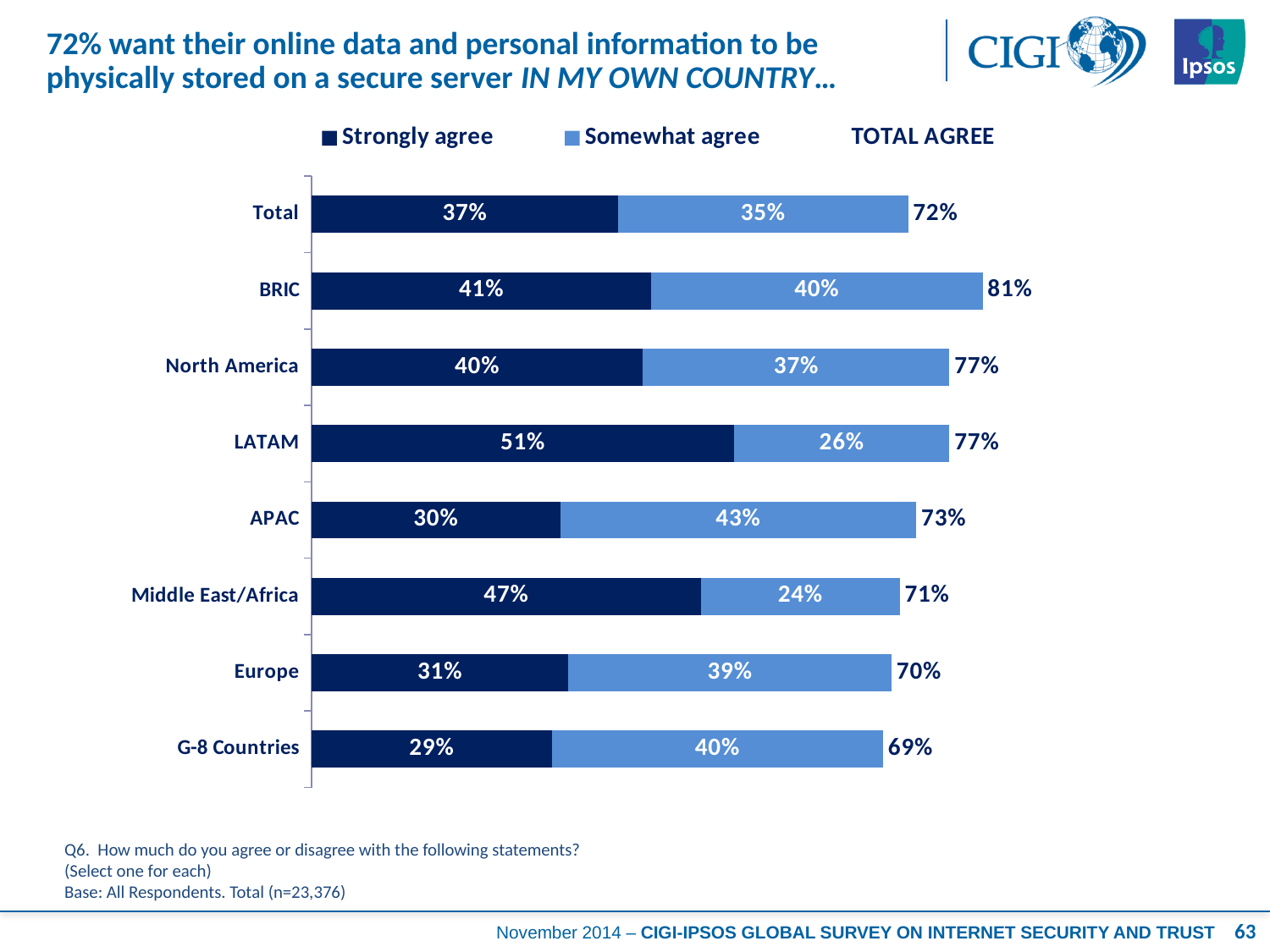
What is the total of the stacked bar for Middle East/Africa? 71% What is the TOTAL AGREE value for BRIC? 81% How many series does the legend list? 3 Which series is shown in the darker blue colour? Strongly agree What is the Somewhat agree value for APAC? 43% What kind of chart is shown on the slide? Stacked bar chart How many categories are shown on the chart? 8 What is the difference between the Strongly agree values for LATAM and Europe? 20% Which category has the lowest Strongly agree value? G-8 Countries What is the Strongly agree value for LATAM? 51% Which has a larger Somewhat agree value, North America or Middle East/Africa? North America Which region has the highest TOTAL AGREE value? BRIC